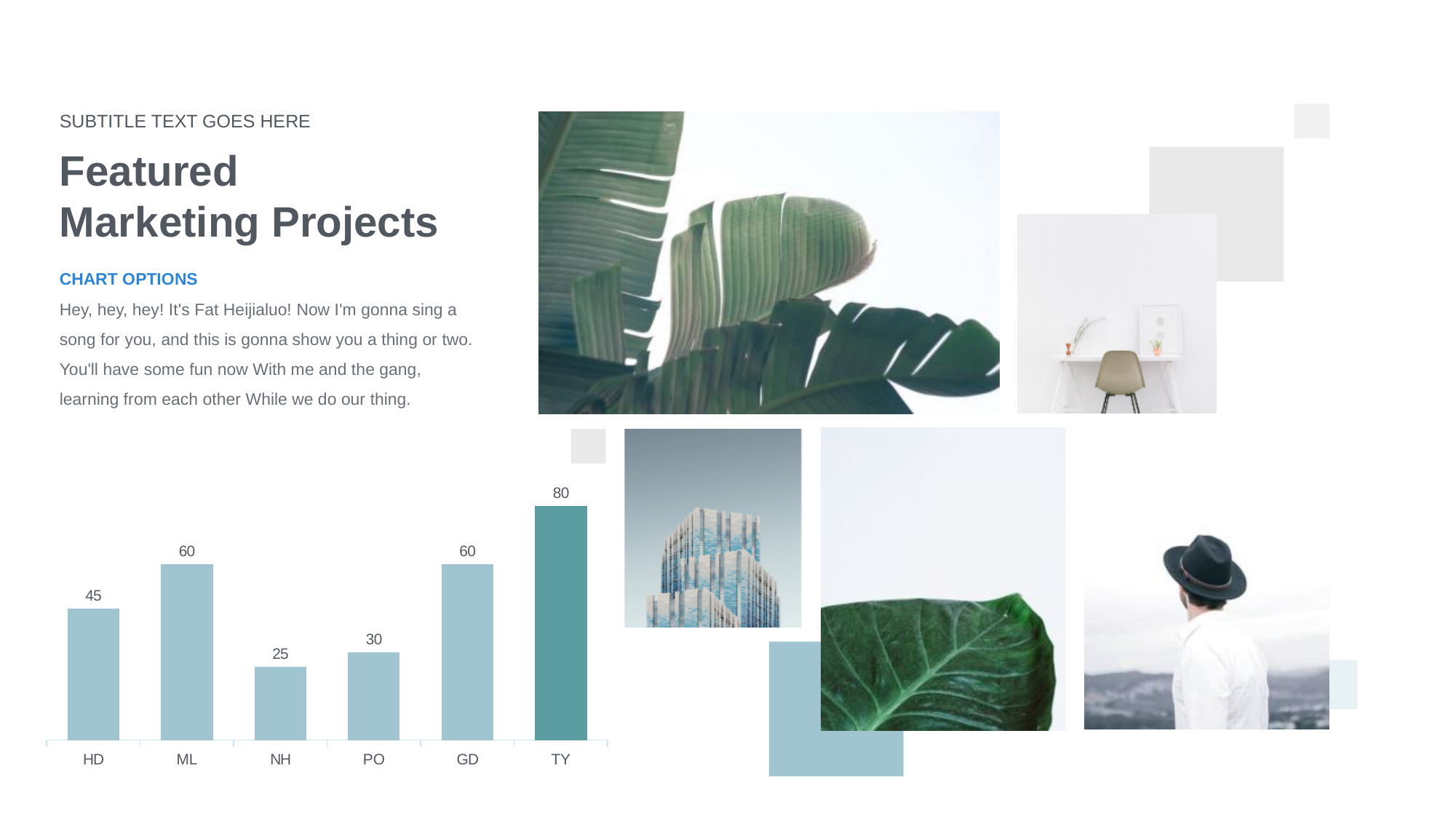
What is the value for PO? 30 Which category has the lowest value? NH What is the value for NH? 25 What is the value for HD? 45 What kind of chart is shown on the slide? Bar chart Which is larger, the value for ML or the value for PO? ML Which category has the highest value? TY What is the difference between the values for HD and NH? 20 How many categories are shown on the x axis? 6 What is the value for TY? 80 Which bar is shown in a darker colour than the others? TY What is the difference between the values for TY and GD? 20